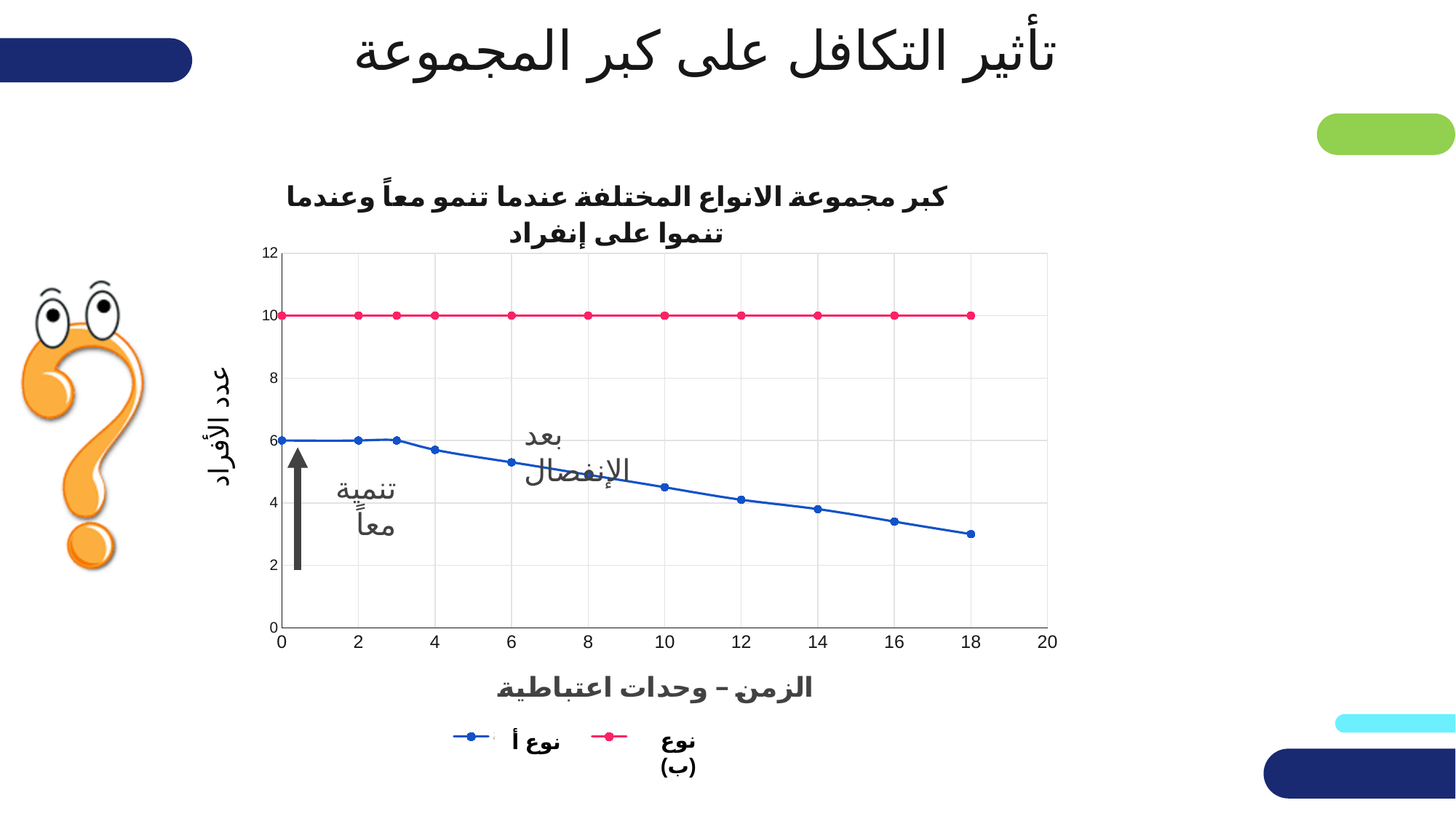
Is the value for نوع أ at time 6 greater or less than 4? greater What is the value of نوع أ at time 0? 6 Which series has the higher value at time 10, نوع أ or نوع (ب)? نوع (ب) What kind of chart is shown on the slide? line chart What is the title of the x axis? الزمن – وحدات اعتباطية What is the value of نوع (ب) at time 10? 10 How many series does the legend list? 2 What are the two series named in the legend? نوع أ and نوع (ب) Do the values of نوع أ rise or fall as time increases? fall What is the difference between نوع (ب) and نوع أ at time 0? 4 How many data points are plotted for the نوع (ب) series? 11 Is the value for نوع أ at time 18 greater or less than 4? less